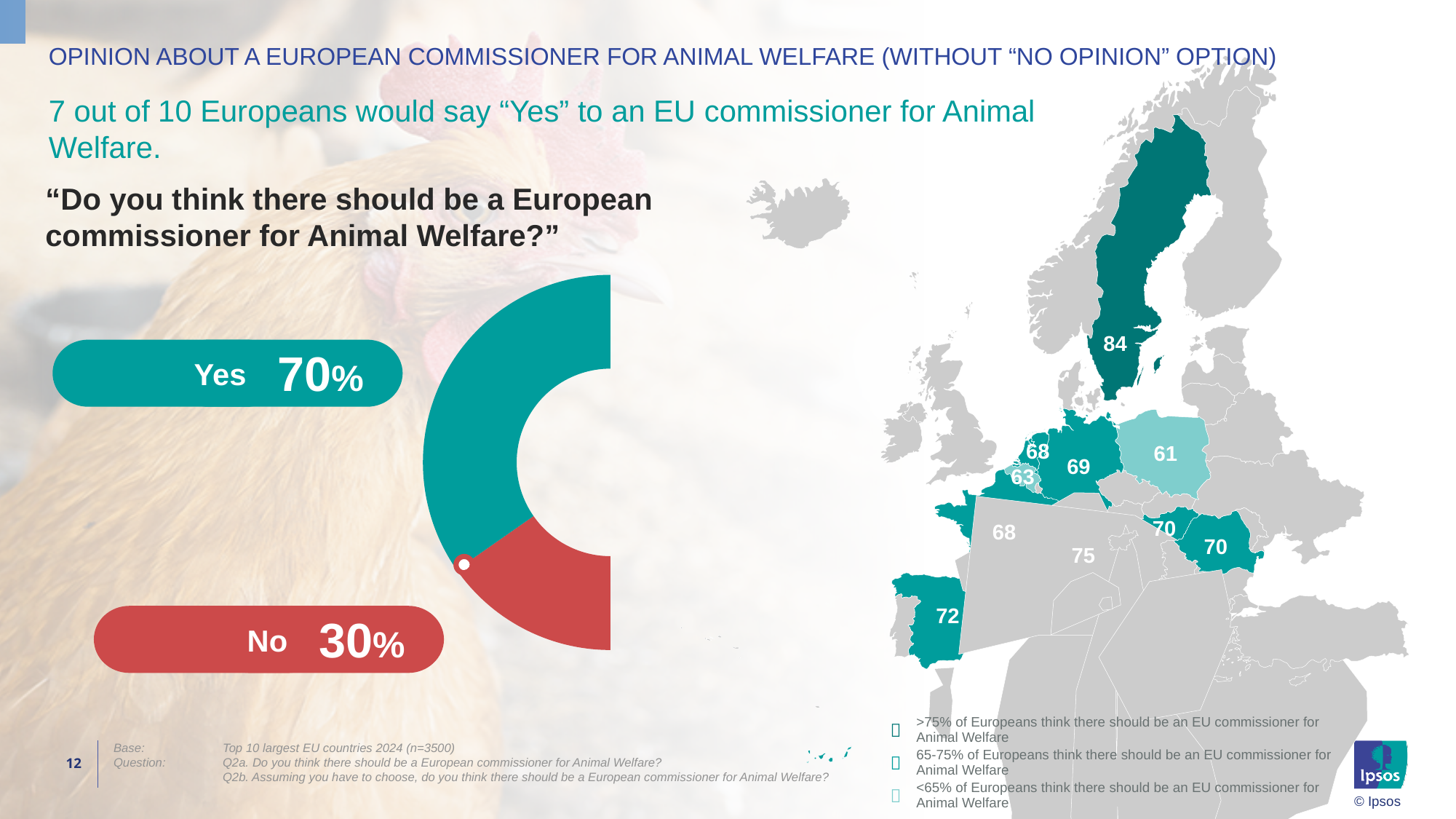
In the donut chart on the left, which answer has the larger share, Yes or No? Yes How many categories does the donut chart on the left show? 2 In the donut chart on the left, what percentage of respondents answered "No"? 30% In the donut chart on the left, what percentage of respondents answered "Yes"? 70% On the map on the right, what is the highest value printed on any country? 84 How many countries on the map on the right have a value printed on them? 10 On the map on the right, what is the difference between the highest printed value (84) and the lowest printed value (61)? 23 In the donut chart on the left, what is the difference in percentage points between the Yes and No shares? 40 percentage points On the map on the right, what is the lowest value printed on any country? 61 In the donut chart on the left, what colour is the Yes segment? Teal (green) What kind of chart is used on the left of the slide to show the Yes and No shares? Donut (pie) chart How many colour categories does the legend of the map on the right list? 3